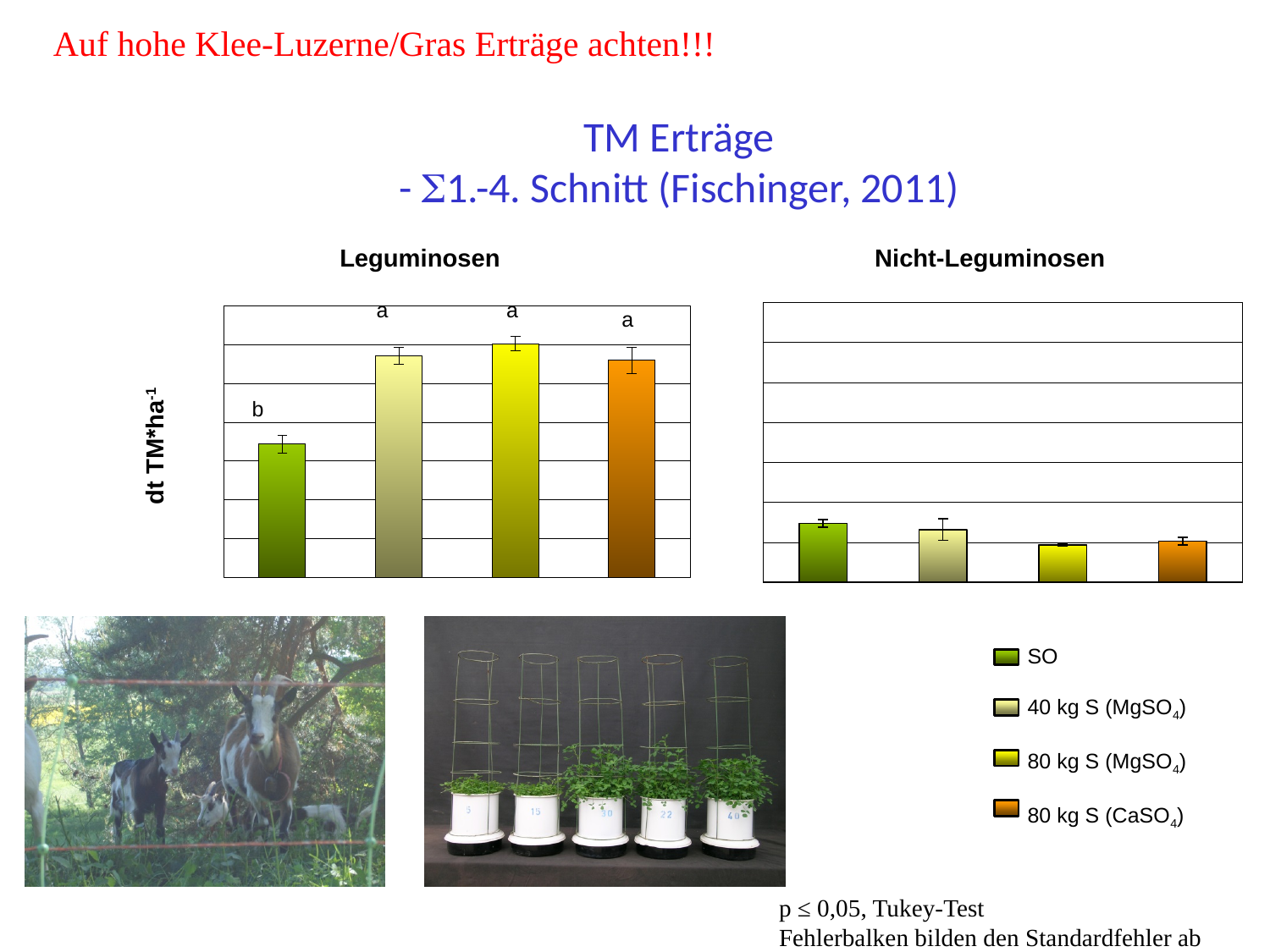
In the Nicht-Leguminosen chart, which is larger: the value for SO or the value for 80 kg S (MgSO4)? SO In the Leguminosen chart, which treatment has the lowest yield? SO Which chart has the higher bars overall, Leguminosen or Nicht-Leguminosen? Leguminosen What is the label on the y axis of the Leguminosen chart? dt TM*ha-1 In the Leguminosen chart, which is larger: the value for SO or the value for 40 kg S (MgSO4)? 40 kg S (MgSO4) How many bars are plotted in the Nicht-Leguminosen chart? 4 What kind of chart is the Leguminosen chart? bar chart In the Leguminosen chart, which treatment has the highest yield? 80 kg S (MgSO4) In the Leguminosen chart, which treatment is marked with the significance letter b? SO How many series does the legend list? 4 How many bars are plotted in the Leguminosen chart? 4